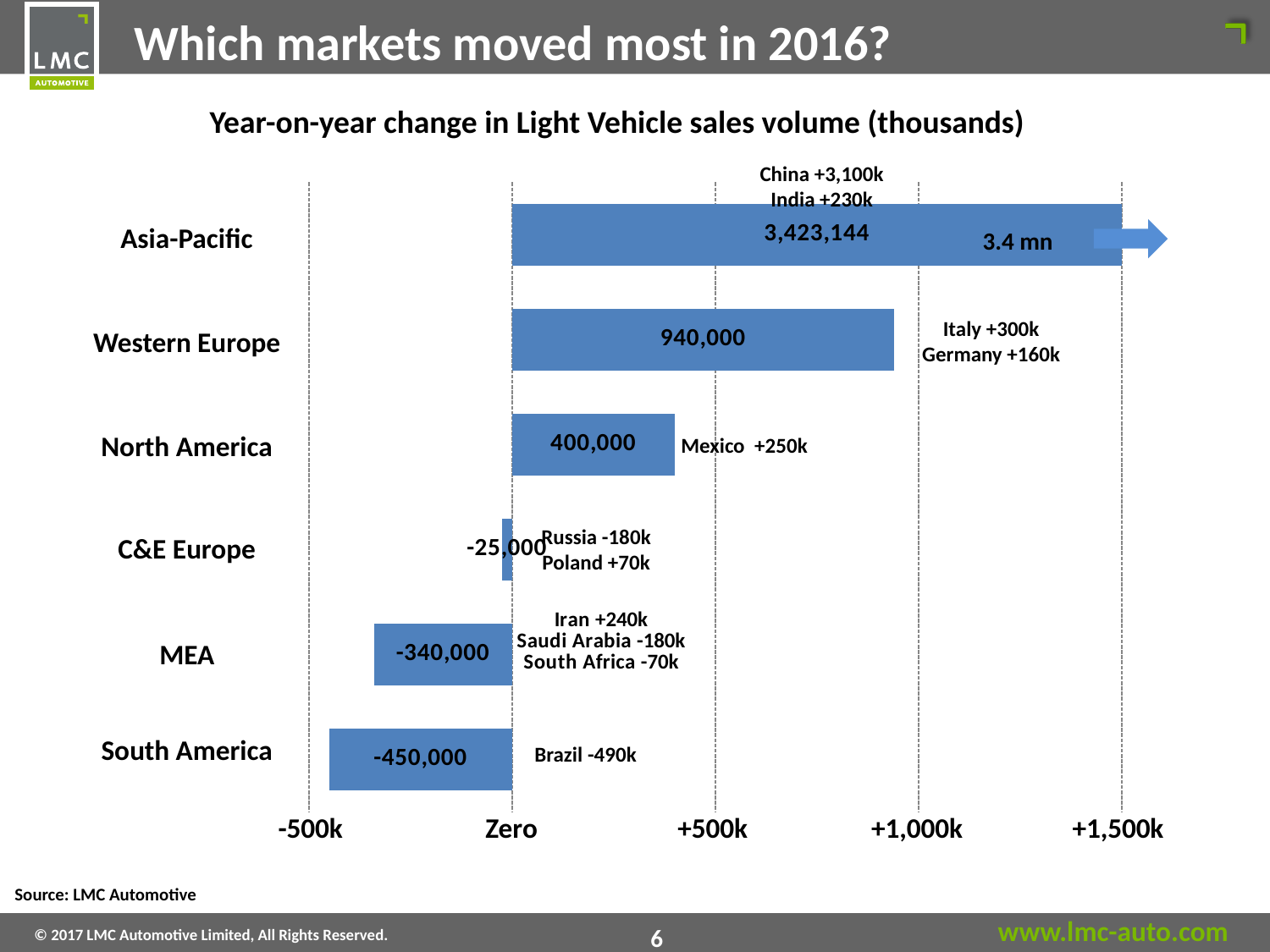
What is the title of the chart? Year-on-year change in Light Vehicle sales volume (thousands) What is the value shown for MEA? -340,000 Which region has the largest year-on-year change in Light Vehicle sales volume? Asia-Pacific Which is larger in absolute terms, the change for MEA or the change for South America? South America What is the value shown for South America? -450,000 What is the difference between the values for Western Europe and North America? 540,000 How many regions are shown in the chart? 6 What is the value shown for North America? 400,000 What is the year-on-year change in Light Vehicle sales volume for Western Europe? 940,000 Which region has the lowest year-on-year change in Light Vehicle sales volume? South America Is the value for Western Europe greater or less than +1,000k? less What kind of chart is shown on the slide? Bar chart